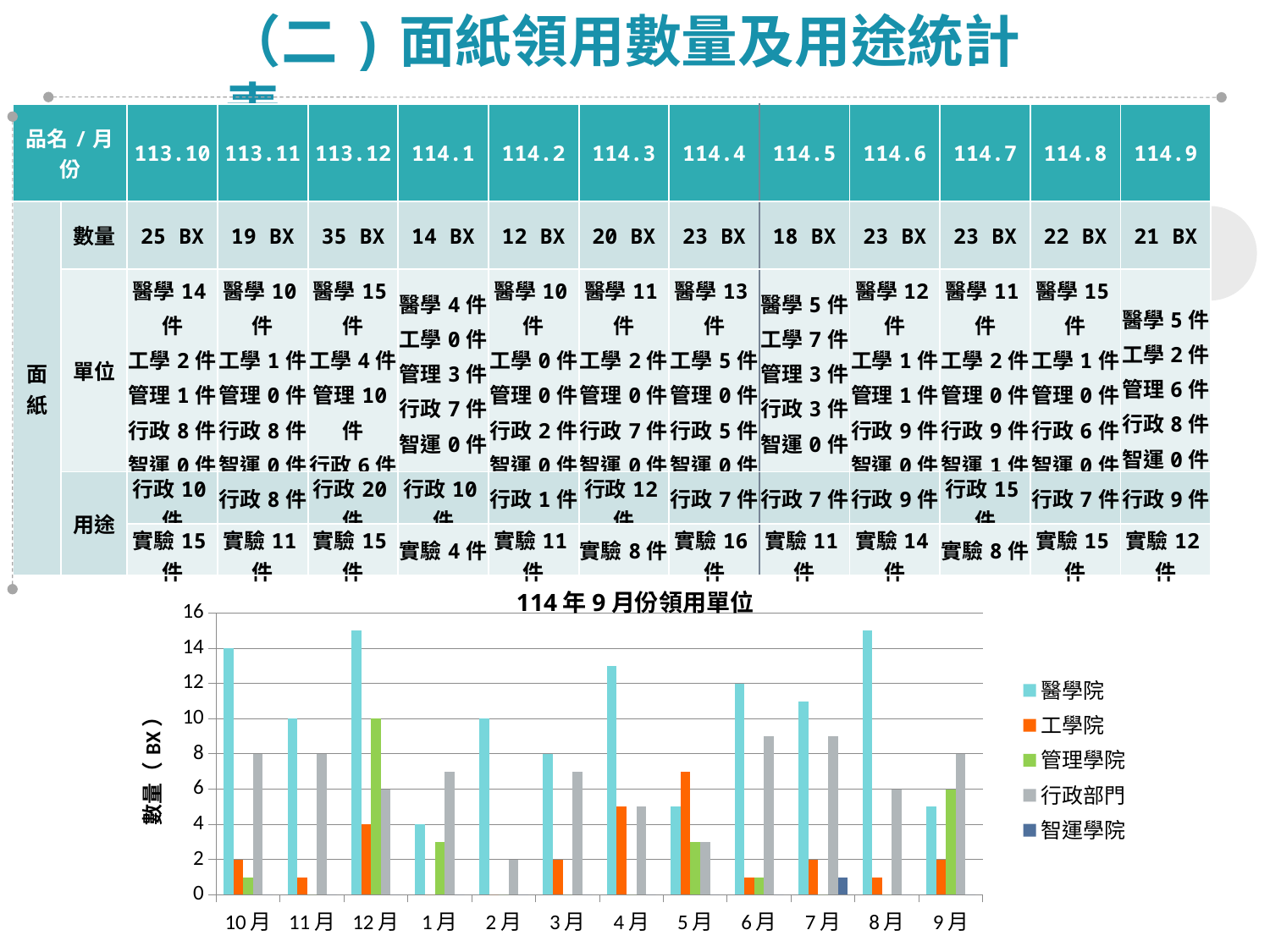
What is the value for 管理學院 in 12月? 10 How many months are shown on the x axis of the chart? 12 What is the value for 醫學院 in 2月? 10 What kind of chart is shown on the slide? bar chart How many series does the chart legend list? 5 In which month is the value for 行政部門 lowest? 2月 Is the value for 醫學院 in 4月 greater or less than 10? greater What is the value for 行政部門 in 10月? 8 In which month is the value for 工學院 highest? 5月 What is the title of the chart? 114年9月份領用單位 What is the value for 醫學院 in 10月? 14 In 5月, which is larger: 工學院 or 醫學院? 工學院